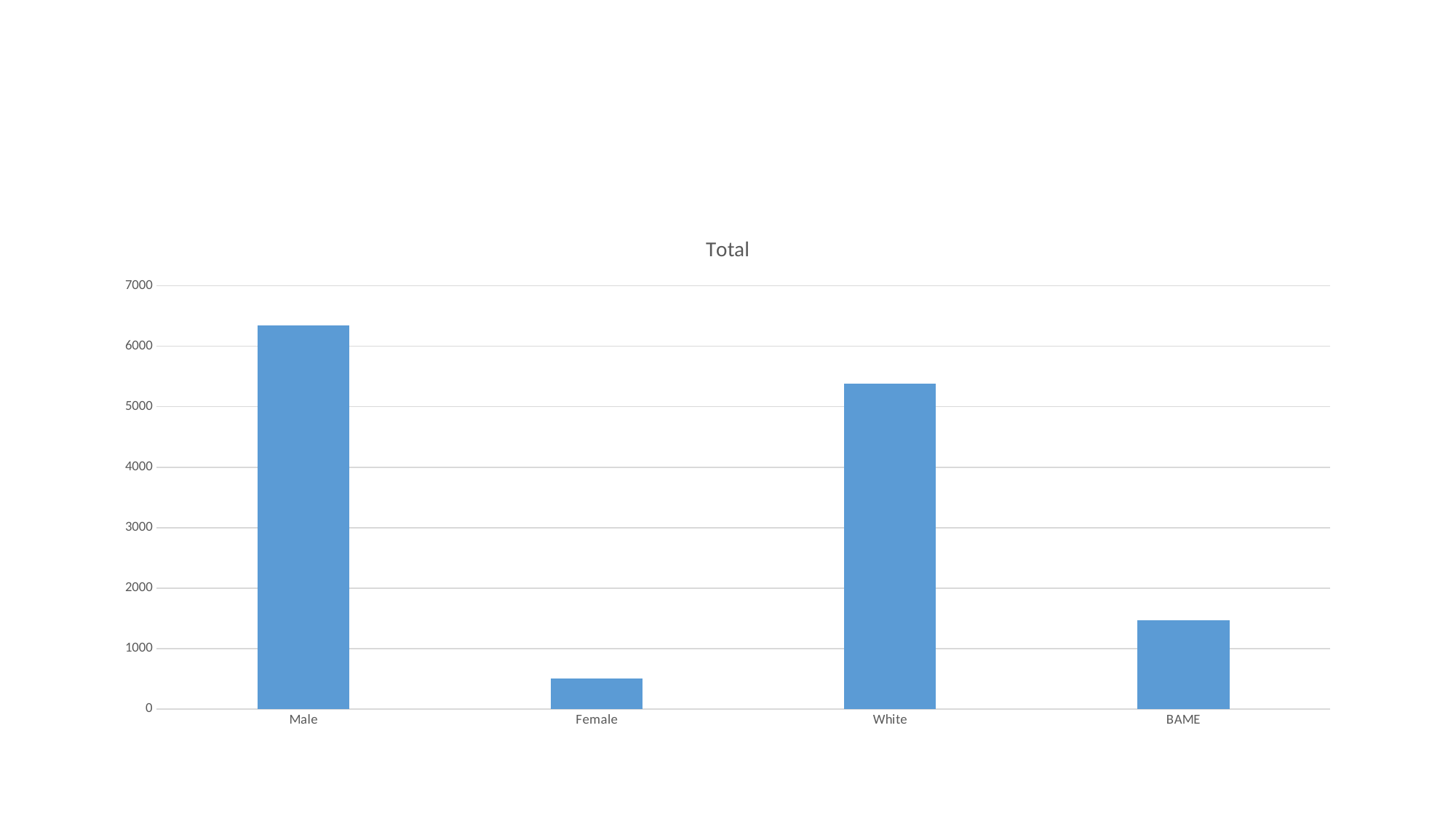
Which category has the lowest value? Female Which category has the highest value? Male Which is larger, the value for White or the value for BAME? White What is the highest value shown on the vertical axis? 7000 What kind of chart is shown on the slide? Bar chart What is the title of the chart? Total Is the value for White greater or less than 5000? greater Is the value for BAME greater or less than 2000? less Is the value for Male greater or less than 6000? greater How many categories are shown on the x axis? 4 Which is larger, the value for Male or the value for White? Male